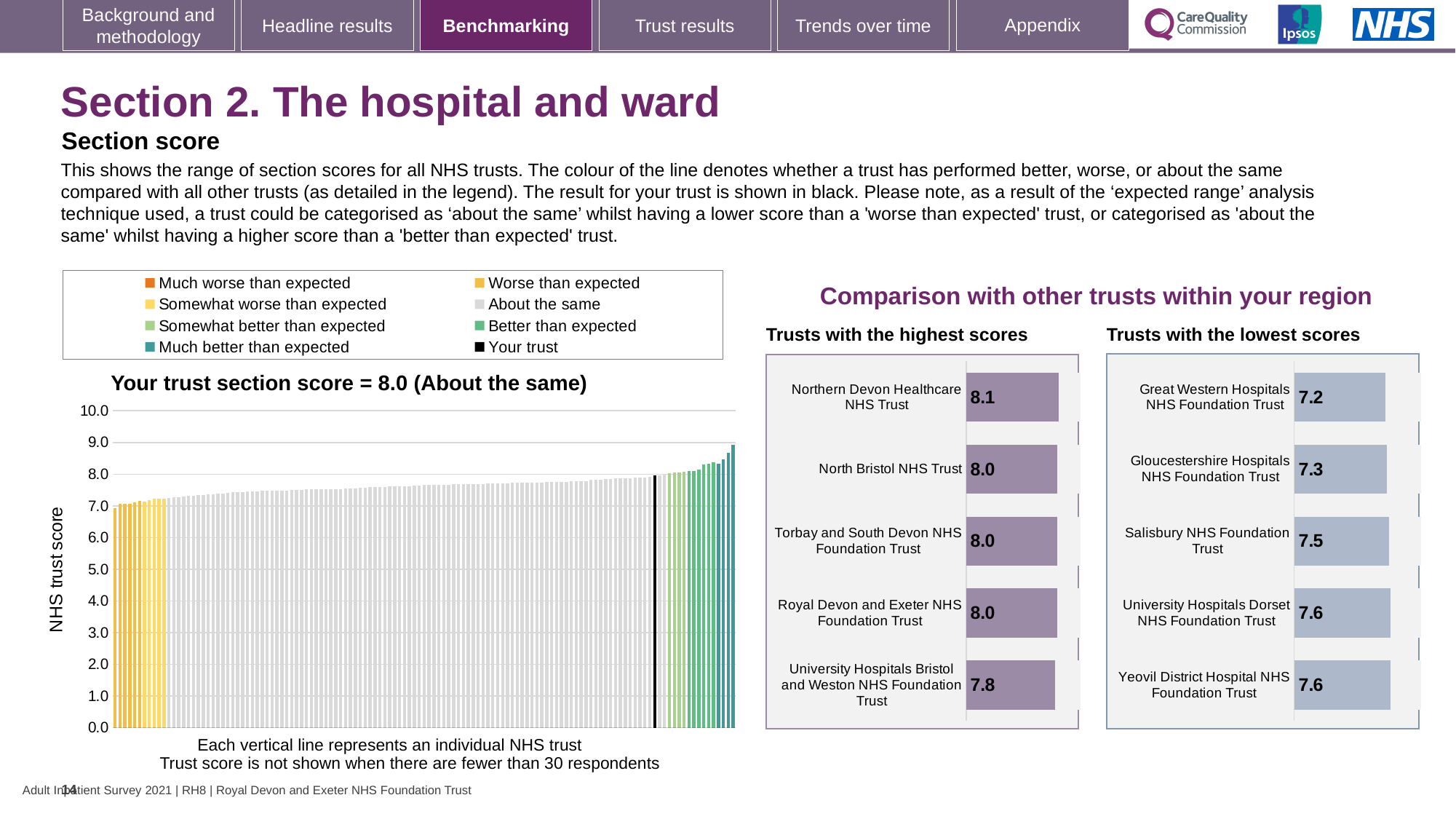
In the 'Your trust section score' chart, what kind of chart is shown? Bar chart In the 'Your trust section score' chart, how many entries does the legend list? 8 In the 'Trusts with the highest scores' chart, what is the score for Northern Devon Healthcare NHS Trust? 8.1 In the 'Trusts with the highest scores' chart, how many trusts are shown? 5 In the 'Your trust section score' chart, what is your trust's section score as stated in the chart title? 8.0 In the 'Your trust section score' chart, do the bar values rise or fall from left to right? Rise In the 'Trusts with the lowest scores' chart, what is the score for Salisbury NHS Foundation Trust? 7.5 In the 'Trusts with the lowest scores' chart, what is the difference between the scores of Salisbury NHS Foundation Trust and Great Western Hospitals NHS Foundation Trust? 0.3 In the 'Trusts with the highest scores' chart, what is the difference between the scores of Northern Devon Healthcare NHS Trust and University Hospitals Bristol and Weston NHS Foundation Trust? 0.3 In the 'Trusts with the highest scores' chart, which trust has the lowest score? University Hospitals Bristol and Weston NHS Foundation Trust In the 'Trusts with the lowest scores' chart, which trust has the lowest score? Great Western Hospitals NHS Foundation Trust In the 'Trusts with the lowest scores' chart, which has the higher score: Gloucestershire Hospitals NHS Foundation Trust or Salisbury NHS Foundation Trust? Salisbury NHS Foundation Trust